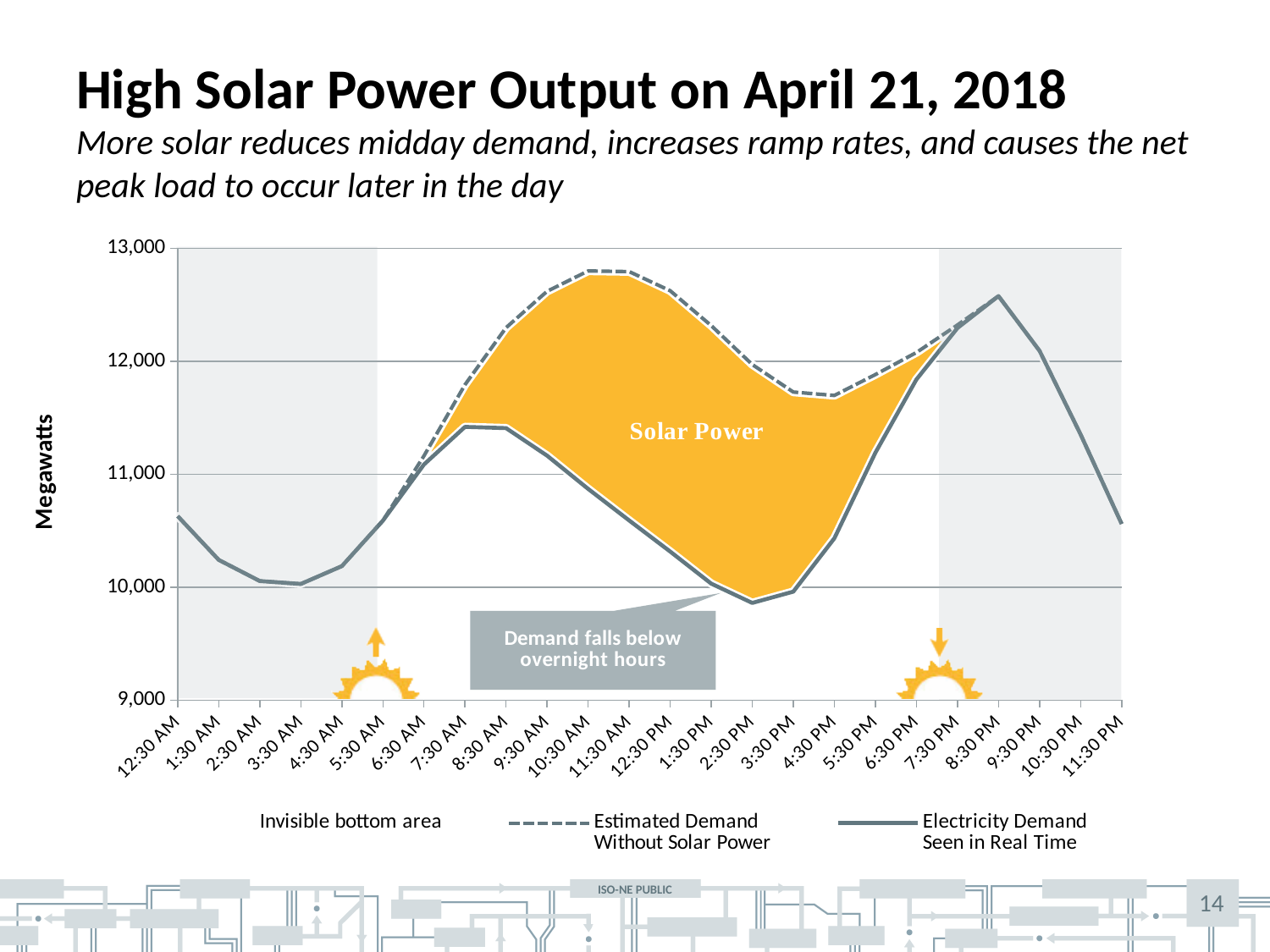
How many time points are labelled along the x axis? 24 Which is larger at 12:30 PM: the Estimated Demand Without Solar Power or the Electricity Demand Seen in Real Time? Estimated Demand Without Solar Power At what time does the Electricity Demand Seen in Real Time reach its highest value? 8:30 PM What label is printed on the shaded area between the two lines? Solar Power Is the Electricity Demand Seen in Real Time at 8:30 PM greater or less than 12,000? greater Is the Estimated Demand Without Solar Power at 10:30 AM greater or less than 12,000? greater How many entries does the chart legend list? 3 At what time does the Electricity Demand Seen in Real Time reach its lowest value? 2:30 PM What kind of chart is shown on the slide? Combination area and line chart Is the Electricity Demand Seen in Real Time at 12:30 AM greater or less than 10,000? greater Does the Electricity Demand Seen in Real Time rise or fall between 8:30 PM and 11:30 PM? Fall